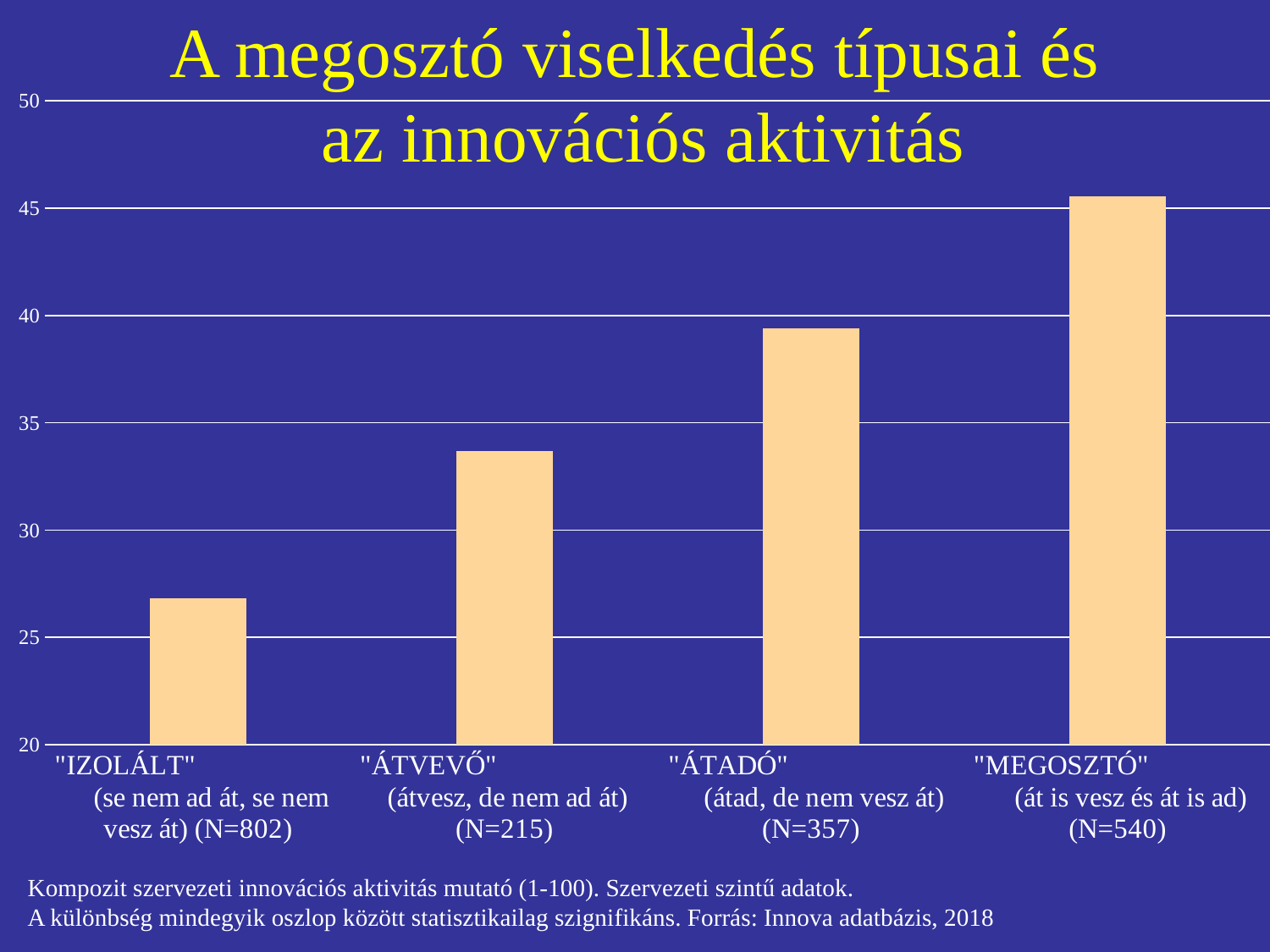
Which has the larger value, "ÁTVEVŐ" or "ÁTADÓ"? "ÁTADÓ" Which category has the lowest value? "IZOLÁLT" Which category has the highest value? "MEGOSZTÓ" Is the value for "ÁTVEVŐ" greater or less than 30? greater What kind of chart is shown on the slide? bar chart Is the value for "IZOLÁLT" greater or less than 30? less What is the sample size (N) shown for the "ÁTADÓ" category? N=357 What is the title of the chart? A megosztó viselkedés típusai és az innovációs aktivitás Do the values rise or fall from left to right across the categories? rise Is the value for "ÁTADÓ" greater or less than 40? less How many categories (bars) does the chart show? 4